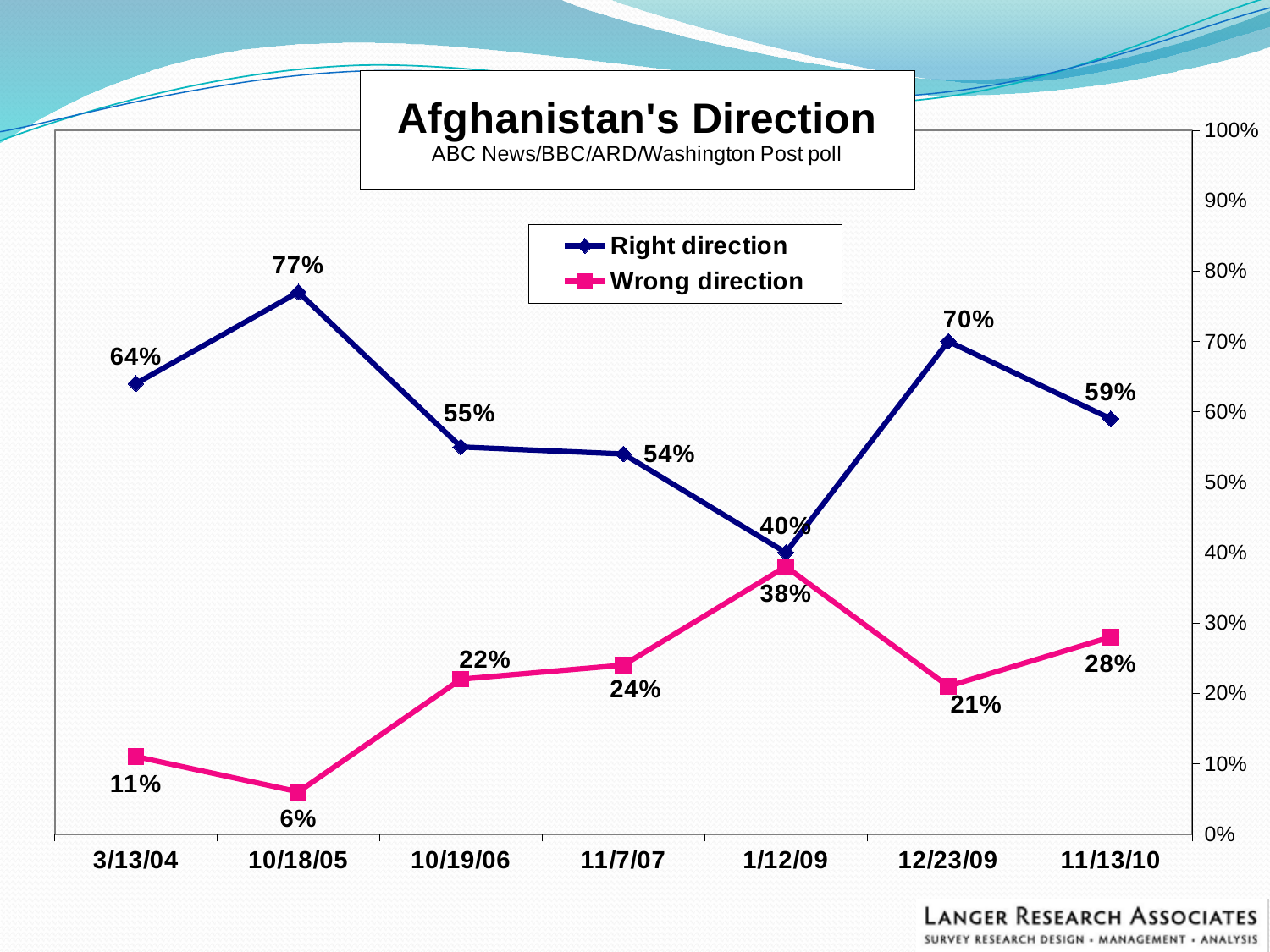
How many dates are plotted on the x axis? 7 Which is larger on 3/13/04: Right direction or Wrong direction? Right direction What is the difference between Right direction and Wrong direction on 12/23/09? 49 percentage points Does the Wrong direction value rise or fall from 10/18/05 to 1/12/09? Rise What is the title of the chart? Afghanistan's Direction On which date is the Wrong direction value lowest? 10/18/05 What kind of chart is this? Line chart How many series does the legend list? 2 What is the value for Wrong direction on 1/12/09? 38% What is the value for Wrong direction on 11/13/10? 28% What is the value for Right direction on 10/18/05? 77% On which date is the Right direction value highest? 10/18/05